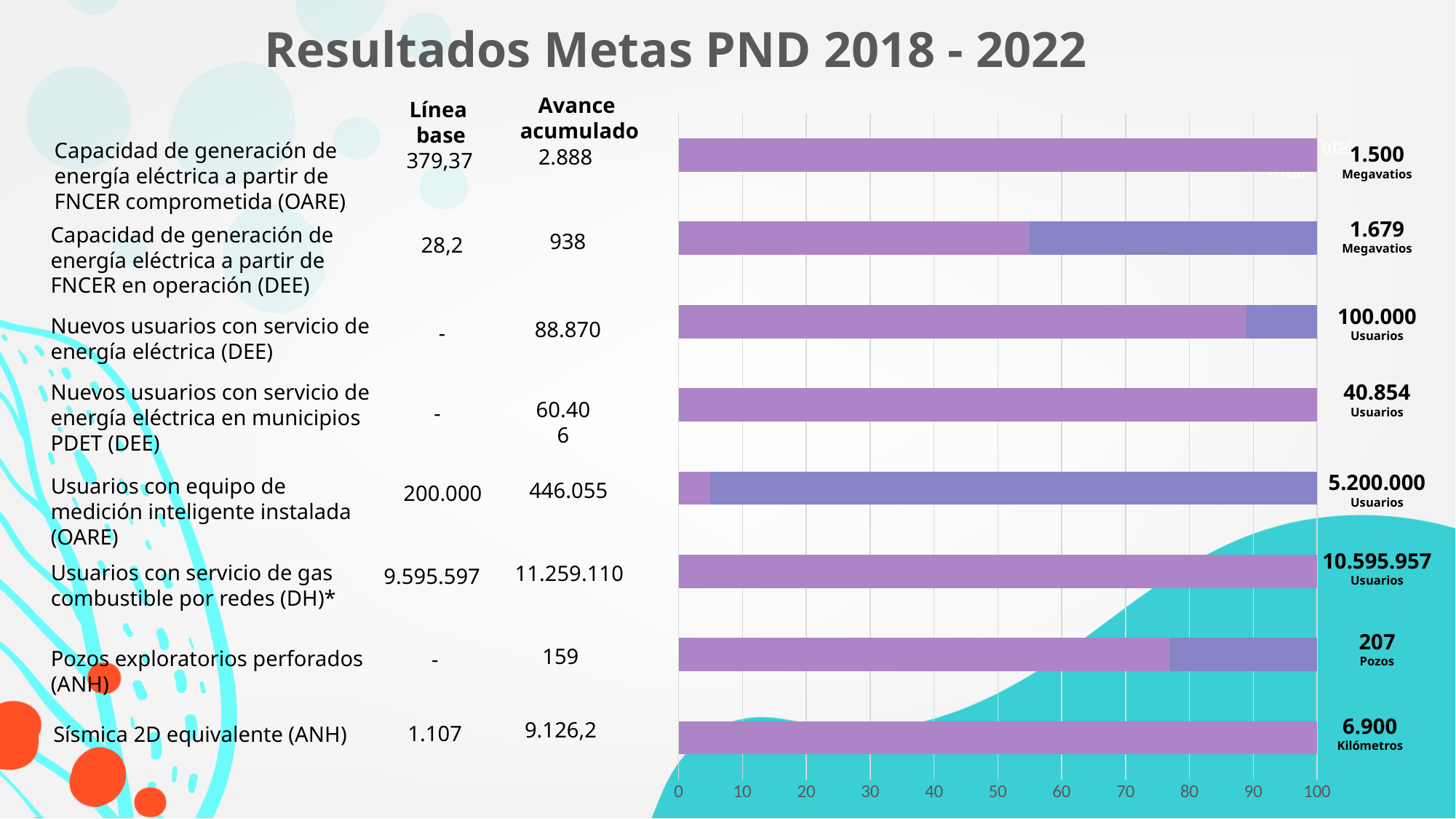
Is the light purple segment of the bar for 'Usuarios con equipo de medición inteligente instalada (OARE)' greater or less than 10? less What target value is printed to the right of the bar for 'Sísmica 2D equivalente (ANH)'? 6.900 Kilómetros How many bars does the chart contain? 8 What is the highest value shown on the chart's horizontal axis? 100 Is the light purple segment of the bar for 'Capacidad de generación de energía eléctrica a partir de FNCER en operación (DEE)' greater or less than 50? greater Is the light purple segment of the bar for 'Pozos exploratorios perforados (ANH)' greater or less than 70? greater Which bar has the smallest light purple segment? Usuarios con equipo de medición inteligente instalada (OARE) What target value is printed to the right of the bar for 'Capacidad de generación de energía eléctrica a partir de FNCER comprometida (OARE)'? 1.500 Megavatios What target value is printed to the right of the bar for 'Usuarios con equipo de medición inteligente instalada (OARE)'? 5.200.000 Usuarios What target value is printed to the right of the bar for 'Pozos exploratorios perforados (ANH)'? 207 Pozos What kind of chart is shown on the slide? bar chart How many bars are split into two colour segments? 4